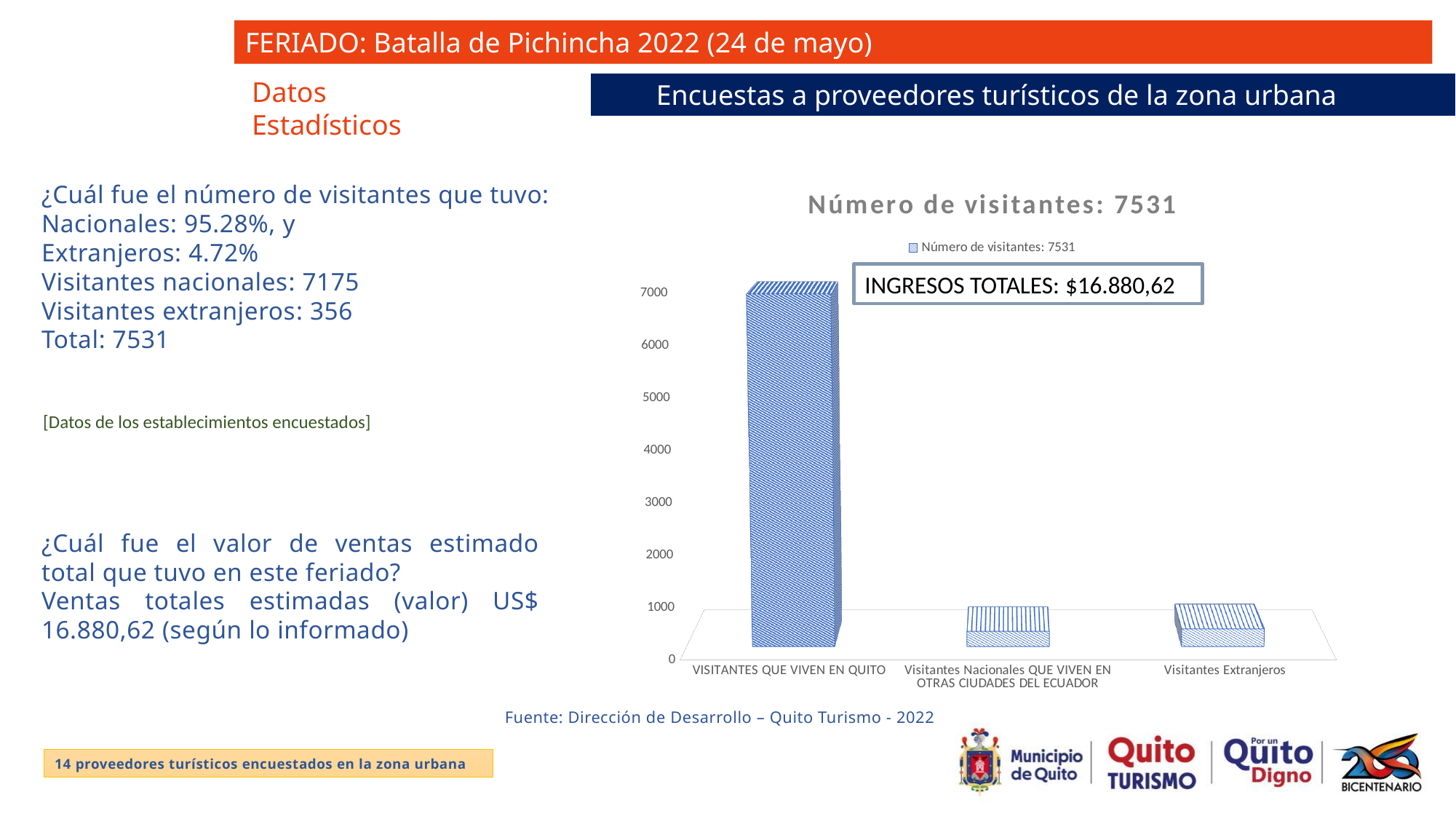
Which category has the highest bar in the chart? VISITANTES QUE VIVEN EN QUITO Is the value for Visitantes Extranjeros greater or less than 1000? less Is the value for Visitantes Nacionales QUE VIVEN EN OTRAS CIUDADES DEL ECUADOR greater or less than 1000? less Is the value for VISITANTES QUE VIVEN EN QUITO greater or less than 6000? greater Which is larger, the bar for VISITANTES QUE VIVEN EN QUITO or the bar for Visitantes Extranjeros? VISITANTES QUE VIVEN EN QUITO How many series does the chart legend list? 1 What is the title of the chart? Número de visitantes: 7531 What kind of chart is shown on the slide? bar chart What is the highest tick value shown on the chart's vertical axis? 7000 How many categories are shown on the x axis of the chart? 3